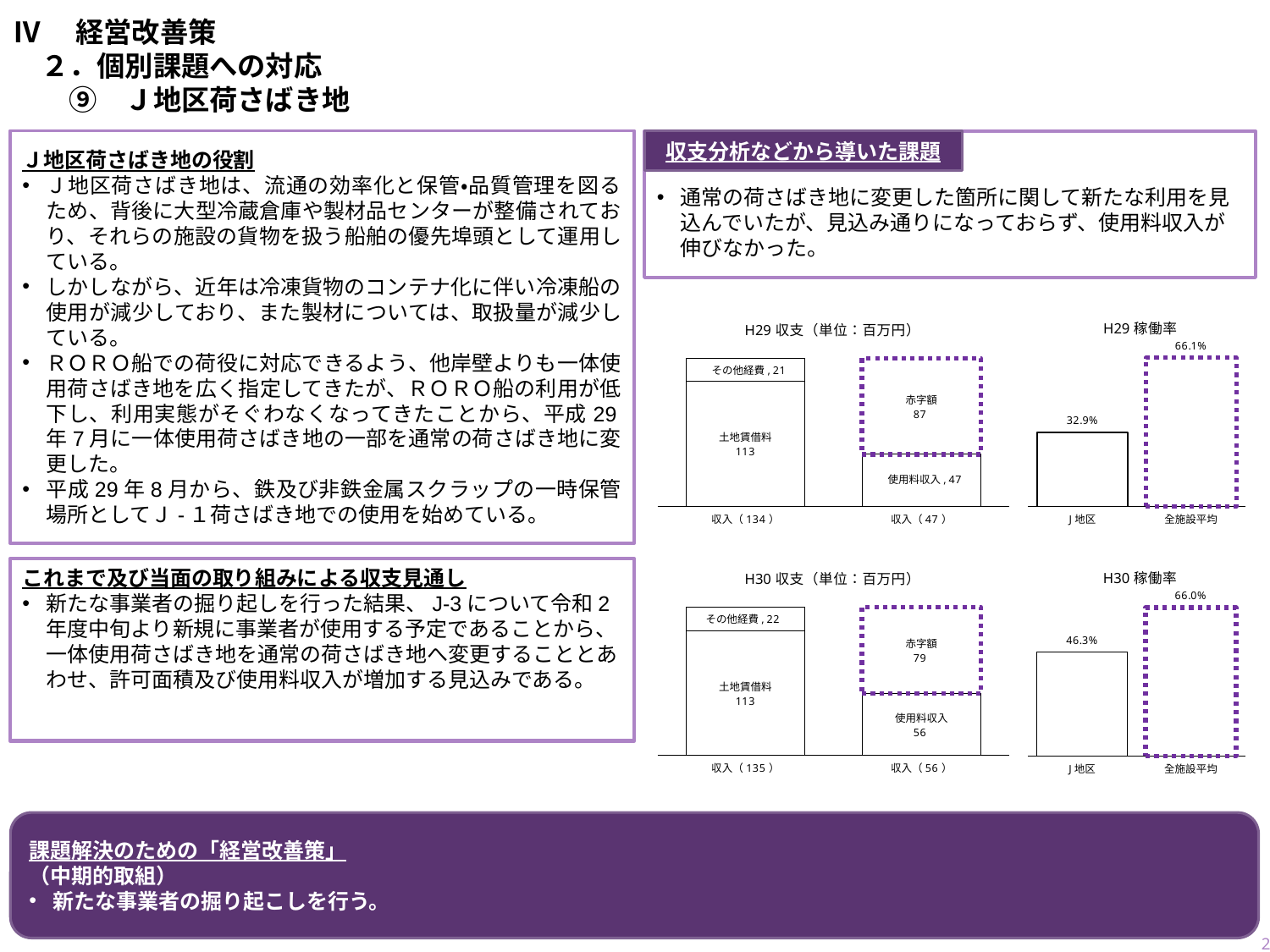
In the H29 収支 chart, which is larger, 赤字額 or 使用料収入? 赤字額 What kind of chart is the H30 稼働率 chart? bar chart In the H29 稼働率 chart, what is the value for 全施設平均? 66.1% In the H29 稼働率 chart, which category is lower, J地区 or 全施設平均? J地区 In the H30 収支 chart, what is the total of 使用料収入 and 赤字額 in the right-hand bar? 135 In the H29 稼働率 chart, what is the value for J地区? 32.9% In the H30 収支 chart, what is the value of 使用料収入? 56 In the H29 収支 chart, what is the total of the bar labelled 収入（134）, made up of 土地賃借料 and その他経費? 134 In the H30 収支 chart, what is the value of その他経費? 22 In the H29 収支 chart, what is the value of 赤字額? 87 In the H30 稼働率 chart, what is the difference between 全施設平均 and J地区? 19.7% In the H30 稼働率 chart, what is the value for J地区? 46.3%